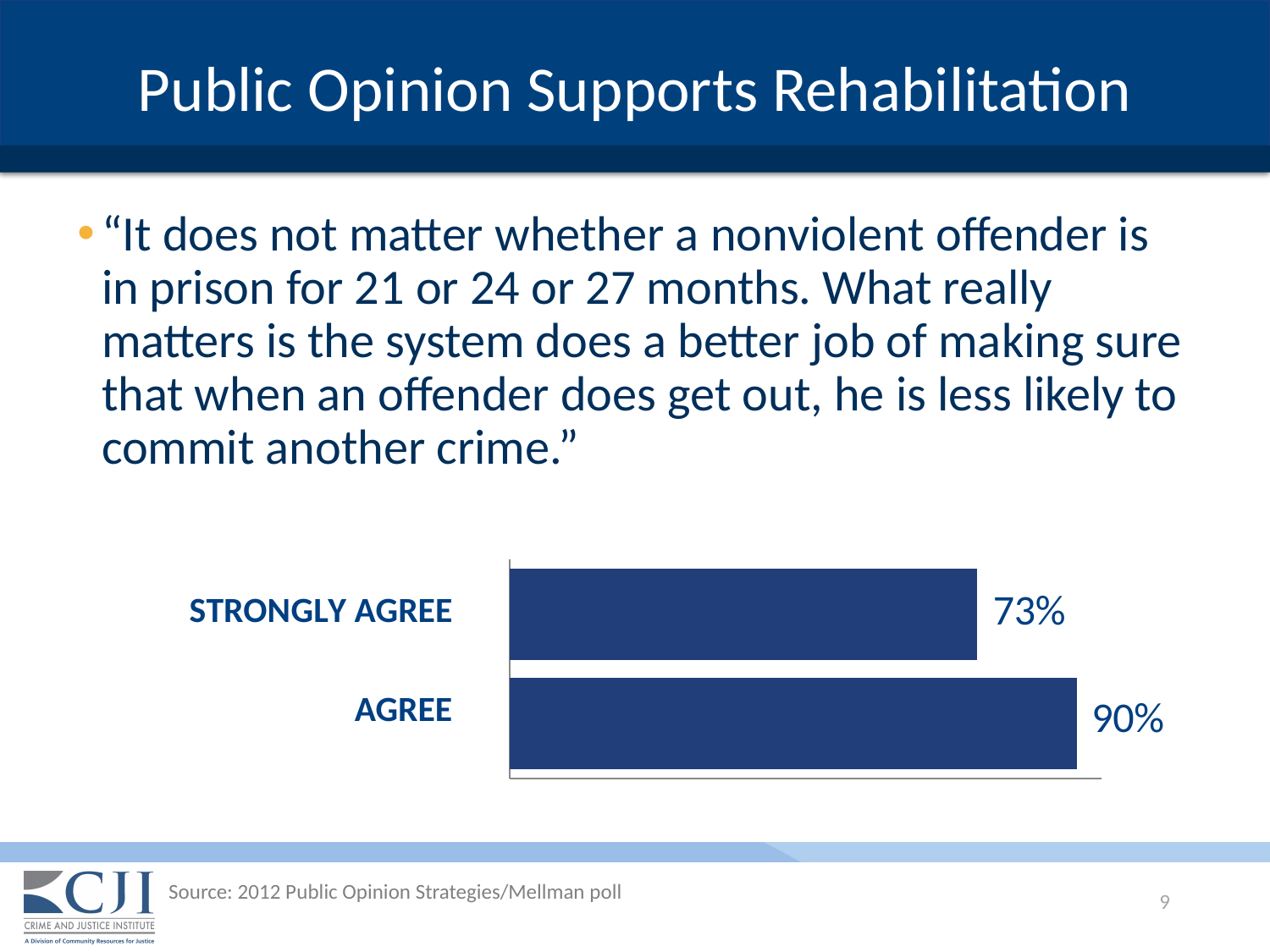
Which category has the higher value, STRONGLY AGREE or AGREE? AGREE What is the title of the slide containing the chart? Public Opinion Supports Rehabilitation Are the bars in the chart horizontal or vertical? horizontal What kind of chart is shown on the slide? bar chart How many categories are shown in the chart? 2 Which category has the lowest value in the chart? STRONGLY AGREE What percentage is shown for AGREE? 90% What percentage is shown for STRONGLY AGREE? 73% Which category has the highest value in the chart? AGREE What is the difference in percentage points between AGREE and STRONGLY AGREE? 17